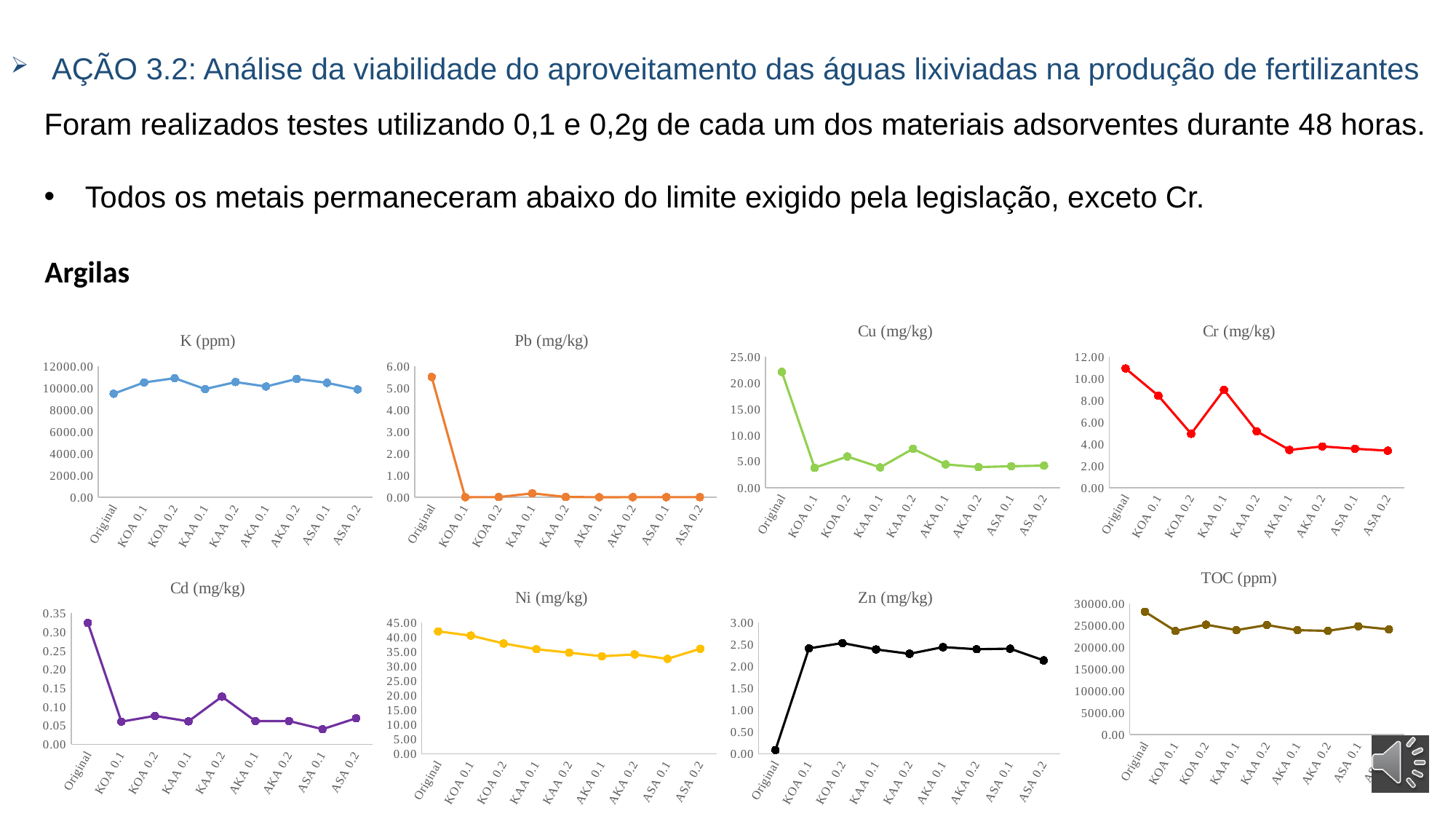
In the Zn (mg/kg) chart, which is larger, the value for Original or the value for KOA 0.1? KOA 0.1 In the TOC (ppm) chart, is the value for Original greater or less than 25000.00? greater In the Cd (mg/kg) chart, which category has the lowest value? ASA 0.1 In the Ni (mg/kg) chart, do the values rise or fall from Original to ASA 0.1? fall In the Zn (mg/kg) chart, which category has the lowest value? Original In the Cu (mg/kg) chart, which category has the highest value? Original How many categories are shown on the x axis of the Cr (mg/kg) chart? 9 In the Cr (mg/kg) chart, is the value for Original greater or less than 10.00? greater What kind of chart is the K (ppm) chart? line chart In the Pb (mg/kg) chart, which category has the highest value? Original What is the title of the chart drawn with a red line? Cr (mg/kg) In the Cr (mg/kg) chart, is the value for KOA 0.2 greater or less than 6.00? less